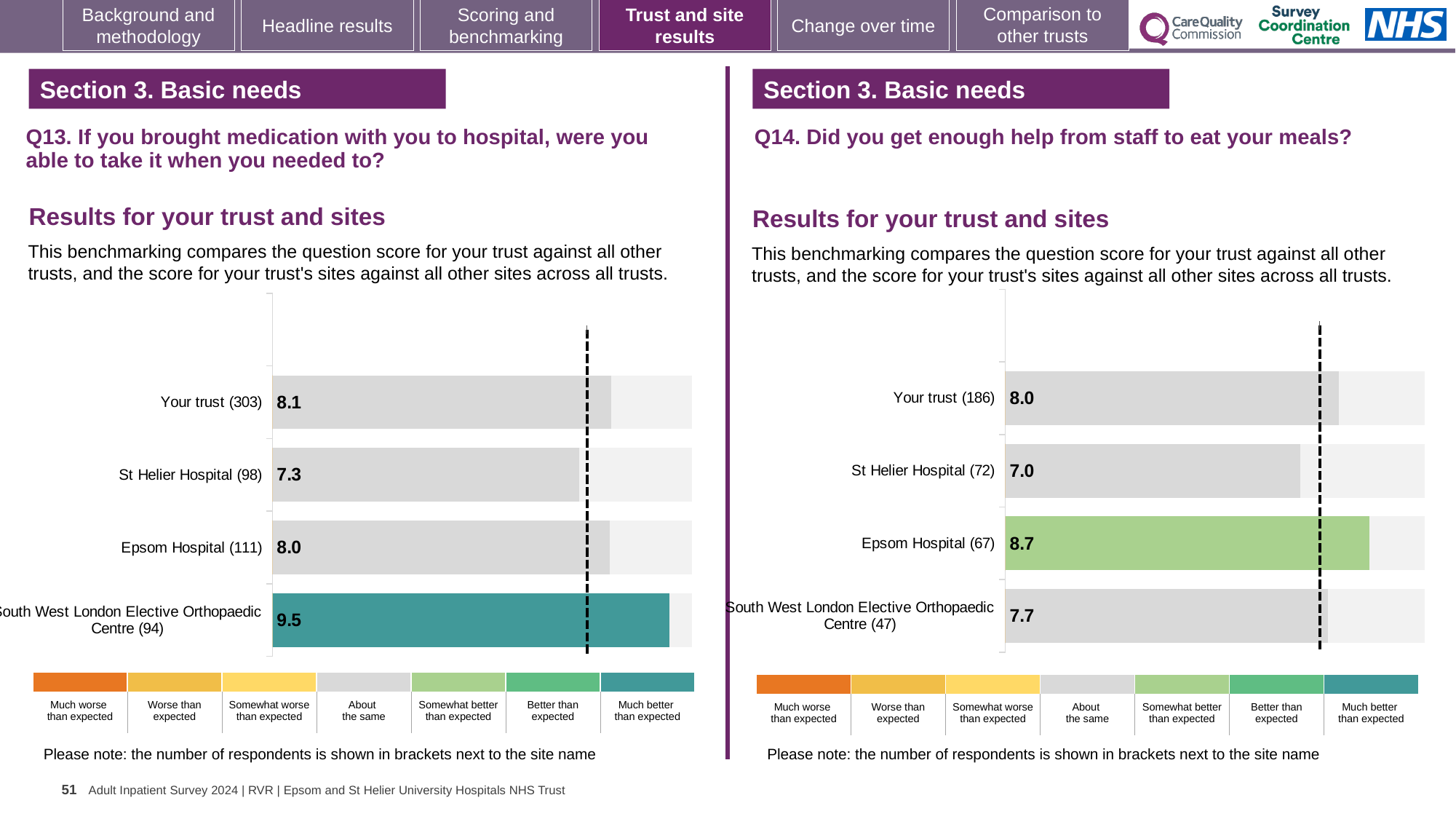
In the Q13 chart on the left, which site has the highest score? South West London Elective Orthopaedic Centre (94) In the Q14 chart on the right, what is the score for Epsom Hospital (67)? 8.7 In the Q13 chart on the left, what is the score for Your trust (303)? 8.1 In the Q14 chart on the right, which is larger: the score for Your trust or the score for St Helier Hospital? Your trust In the Q14 chart on the right, what is the difference between the scores for Epsom Hospital and St Helier Hospital? 1.7 In the Q13 chart on the left, what is the difference between the scores for South West London Elective Orthopaedic Centre and Epsom Hospital? 1.5 In the Q13 chart on the left, which bar has the lowest score? St Helier Hospital (98) In the Q14 chart on the right, what is the score for South West London Elective Orthopaedic Centre (47)? 7.7 In the Q13 chart on the left, what is the score for St Helier Hospital (98)? 7.3 What type of chart is used for the Q14 results on the right? Bar chart In the Q14 chart on the right, which site has the lowest score? St Helier Hospital (72) How many bars are plotted in the Q13 chart on the left? 4